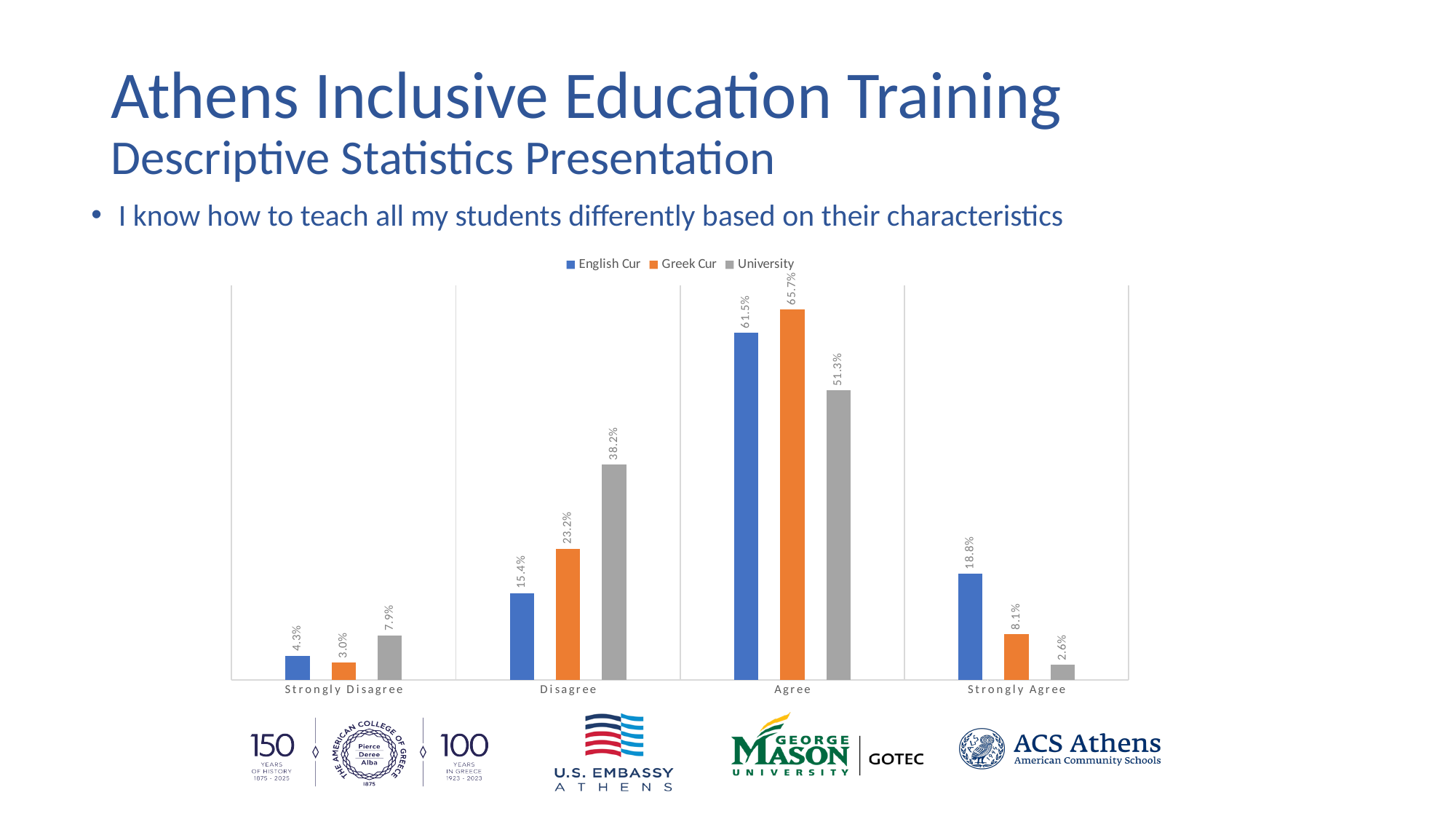
Which category has the lowest value for the English Cur series? Strongly Disagree What is the difference between the Greek Cur and English Cur values in the Agree category? 4.2% What is the value for University in the Disagree category? 38.2% In the Strongly Agree category, which is larger: English Cur or University? English Cur How many series does the legend list? 3 How many categories are shown on the x axis? 4 What kind of chart is shown on the slide? Bar chart What is the value for Greek Cur in the Agree category? 65.7% What is the value for Greek Cur in the Strongly Disagree category? 3.0% Which series is shown in orange in the legend? Greek Cur Which category has the highest value for the University series? Agree What is the value for English Cur in the Strongly Agree category? 18.8%